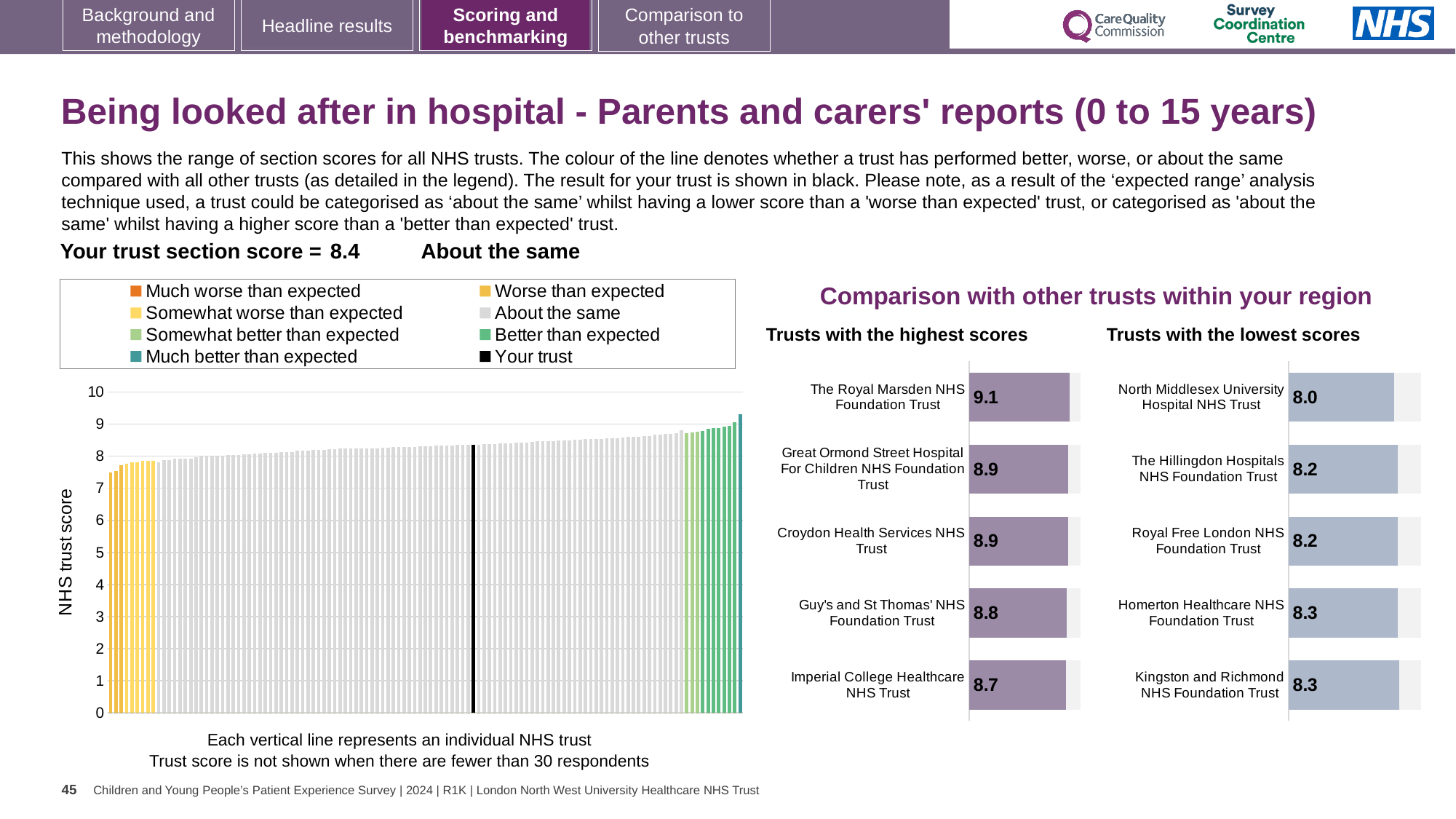
In the 'Trusts with the highest scores' chart, what is the difference between the scores of The Royal Marsden NHS Foundation Trust and Imperial College Healthcare NHS Trust? 0.4 In the main chart on the left showing all NHS trusts, do the values rise or fall from left to right? rise In the 'Trusts with the lowest scores' chart, which trust has the lowest score? North Middlesex University Hospital NHS Trust In the 'Trusts with the lowest scores' chart, what is the score for North Middlesex University Hospital NHS Trust? 8.0 How many trusts are shown in the 'Trusts with the lowest scores' chart? 5 In the main chart on the left showing all NHS trusts, is the value of the leftmost (lowest) bar greater or less than 8? less In the 'Trusts with the highest scores' chart, what is the score for Imperial College Healthcare NHS Trust? 8.7 In the 'Trusts with the lowest scores' chart, which has the higher score: The Hillingdon Hospitals NHS Foundation Trust or Homerton Healthcare NHS Foundation Trust? Homerton Healthcare NHS Foundation Trust In the 'Trusts with the highest scores' chart, which trust has the highest score? The Royal Marsden NHS Foundation Trust How many entries does the legend of the main chart on the left list? 8 In the main chart on the left showing all NHS trusts, what is the section score for your trust (the black line)? 8.4 In the 'Trusts with the highest scores' chart, what is the score for The Royal Marsden NHS Foundation Trust? 9.1